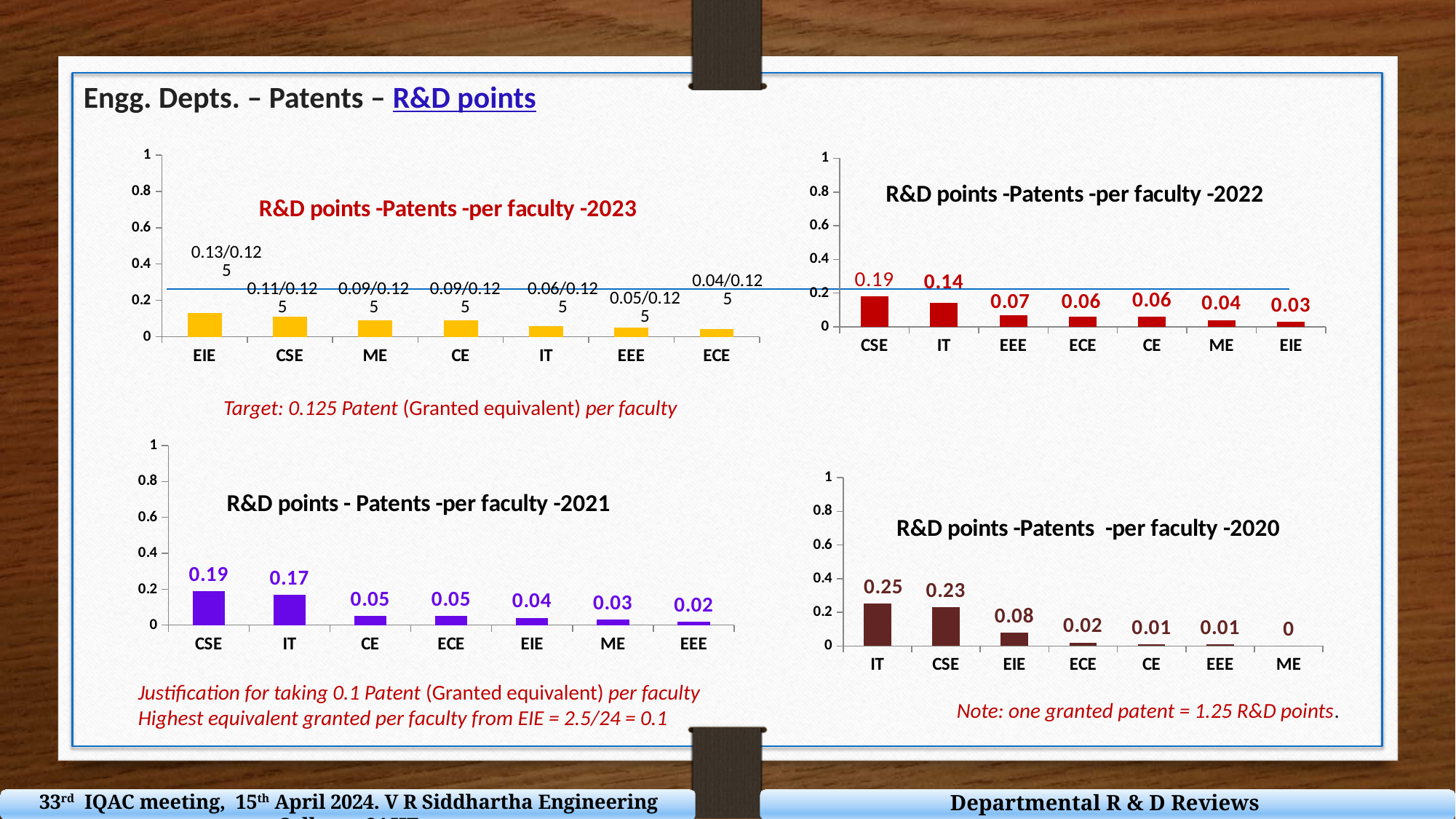
In the 'R&D points - Patents -per faculty -2021' chart, what is the difference between the values for CSE and IT? 0.02 In the 'R&D points -Patents -per faculty -2020' chart, what is the value for ME? 0 In the 'R&D points -Patents -per faculty -2022' chart, what is the value for CSE? 0.19 In the 'R&D points -Patents -per faculty -2023' chart, which department has the highest value? EIE In the 'R&D points -Patents -per faculty -2022' chart, is the value for CSE greater or less than 0.2? less In the 'R&D points -Patents -per faculty -2020' chart, what is the value for EIE? 0.08 In the 'R&D points -Patents -per faculty -2020' chart, which department has the highest value? IT In the 'R&D points -Patents -per faculty -2023' chart, how many departments are shown? 7 In the 'R&D points -Patents -per faculty -2022' chart, which department has the lowest value? EIE What type of chart is the 'R&D points - Patents -per faculty -2021' chart? Bar chart In the 'R&D points -Patents -per faculty -2020' chart, which is larger, the value for IT or the value for CSE? IT In the 'R&D points - Patents -per faculty -2021' chart, what is the value for IT? 0.17